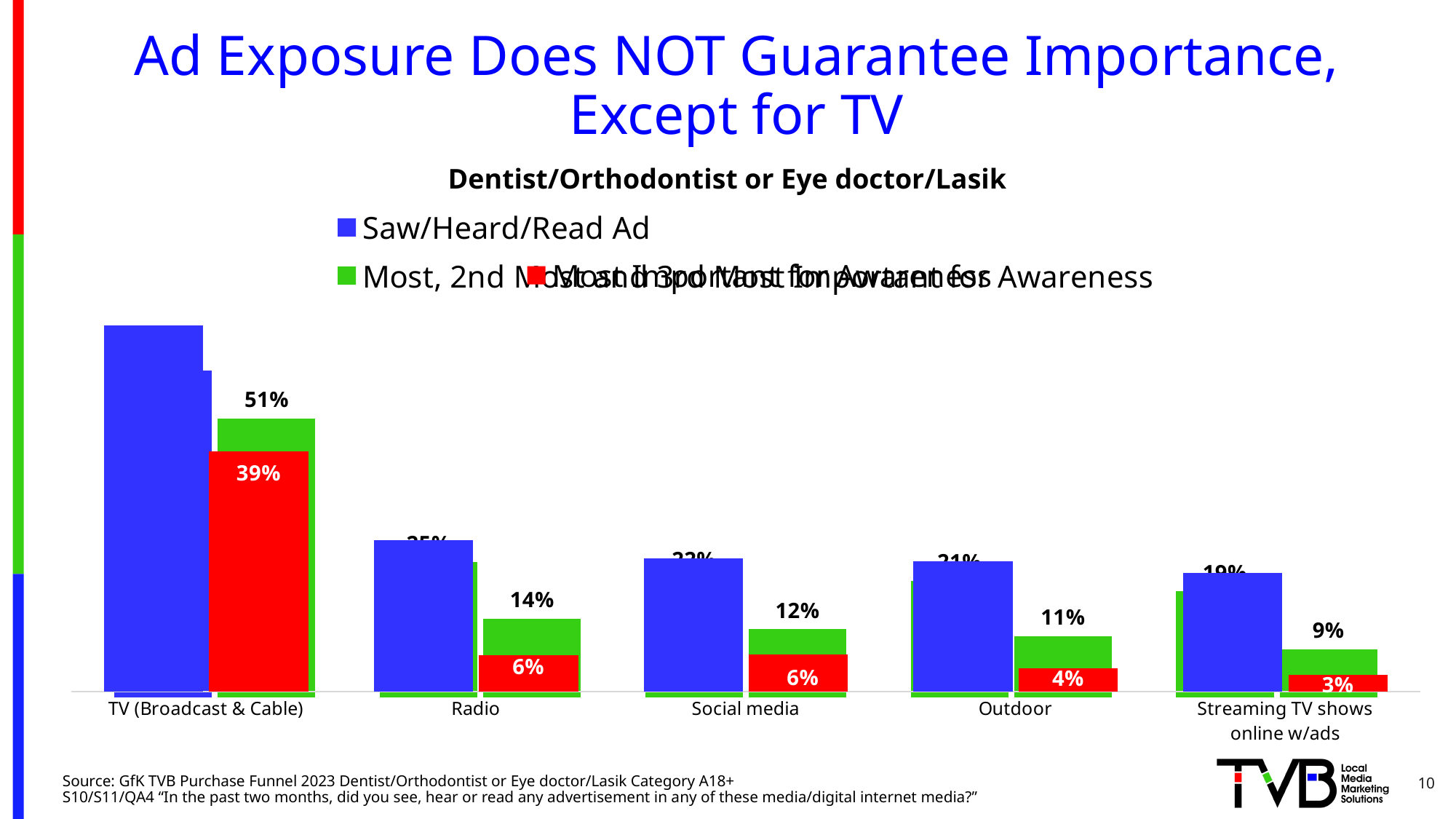
What is the value of the green bar for Radio? 14% What is the difference between the green bar and the red bar for TV (Broadcast & Cable)? 12% What is the value of the green bar for TV (Broadcast & Cable)? 51% What is the value of the green bar for Streaming TV shows online w/ads? 9% Which category has the highest green bar value? TV (Broadcast & Cable) What type of chart is shown on the slide? Bar chart Which has a larger green bar value, Social media or Outdoor? Social media How many media categories are shown on the x axis? 5 What is the value of the red bar for Outdoor? 4% What is the difference between the green bar and the red bar for Radio? 8% Which category has the lowest red bar value? Streaming TV shows online w/ads What is the value of the red bar for TV (Broadcast & Cable)? 39%